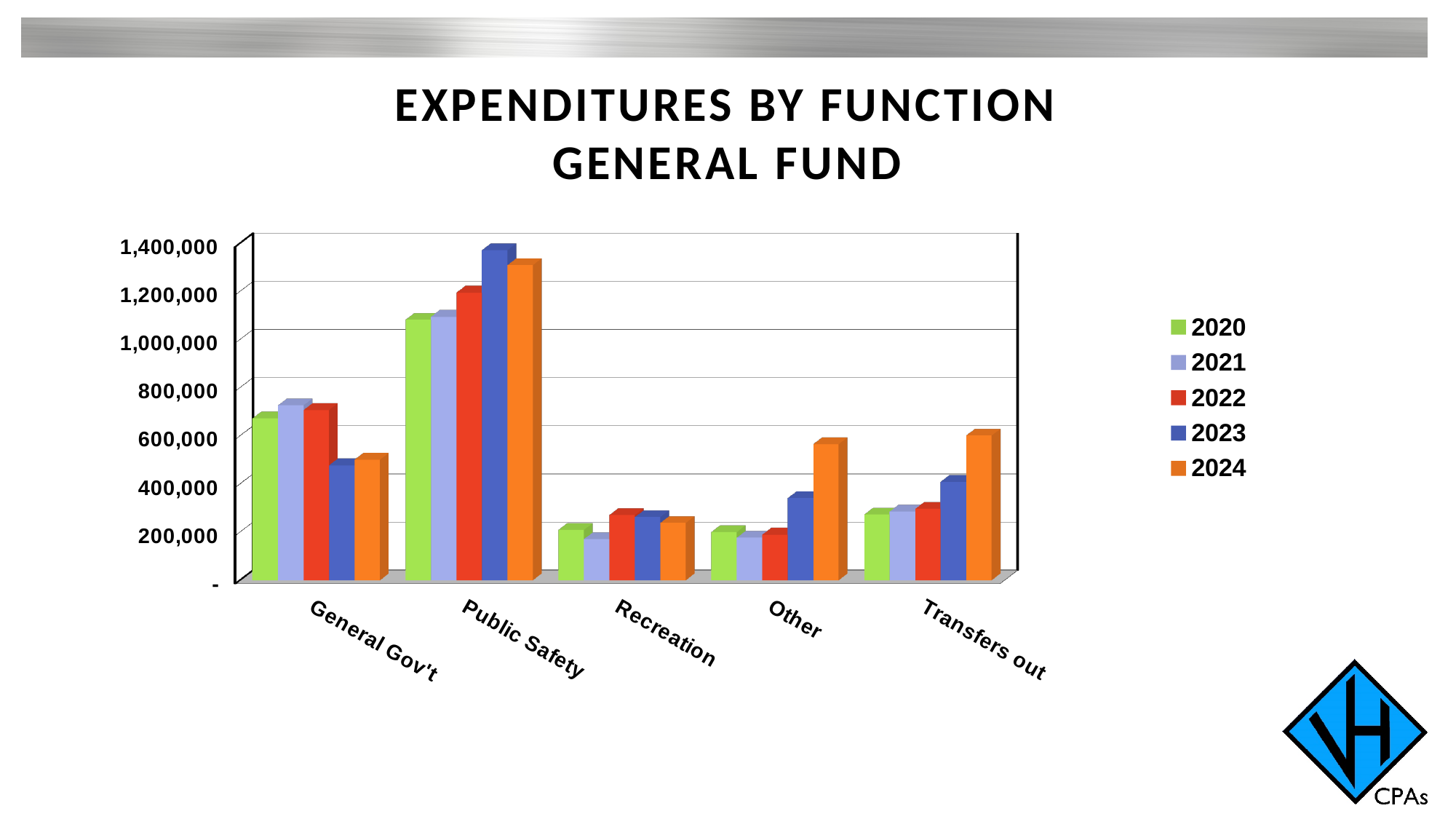
Which is larger for Other: the 2020 value or the 2024 value? 2024 How many series does the legend list? 5 Which function category has the highest expenditures overall? Public Safety Is the value for Public Safety in 2023 greater or less than 1,200,000? greater How many function categories are shown on the x axis? 5 What kind of chart is shown on the slide? Bar chart Is the value for General Gov't in 2020 greater or less than 600,000? greater Is the value for Other in 2024 greater or less than 400,000? greater What is the title of the chart? EXPENDITURES BY FUNCTION GENERAL FUND Which year has the highest bar for Public Safety? 2023 Do the Transfers out values rise or fall from 2020 to 2024? rise